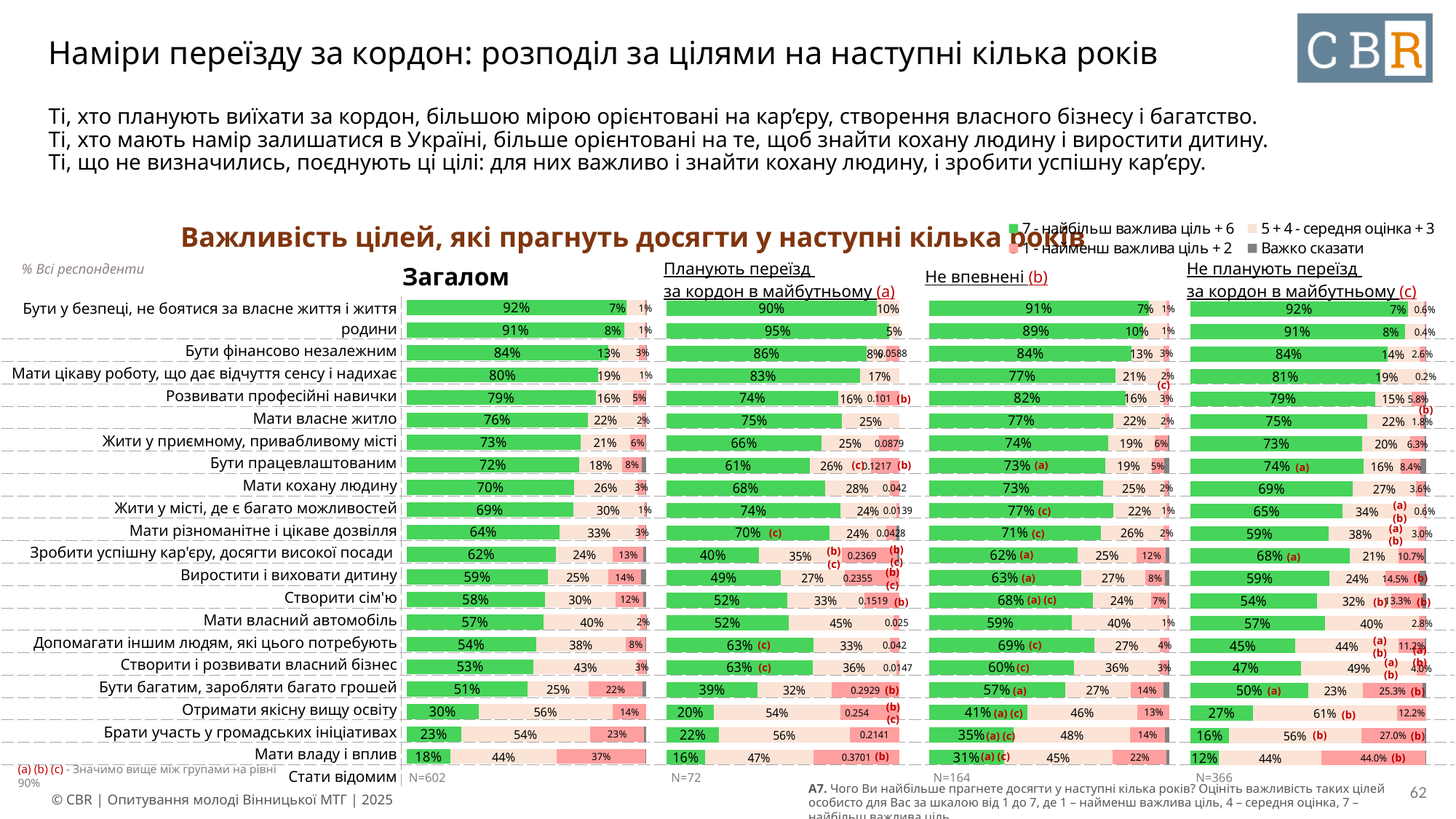
In the 'Загалом' chart, which goal has the lowest green (7 + 6) share? Мати владу і вплив What type of chart is used on this slide? Stacked bar chart What is the difference in percentage points between the green (7 + 6) share for 'Бути багатим, заробляти багато грошей' in the 'Не впевнені (b)' chart and in the 'Не планують переїзд за кордон в майбутньому (c)' chart? 7 percentage points In the 'Не планують переїзд за кордон в майбутньому (c)' chart, which goal has the lowest green (7 + 6) share? Мати владу і вплив Which is larger: the green (7 + 6) share for 'Створити сім'ю' in the 'Загалом' chart or in the 'Планують переїзд за кордон в майбутньому (a)' chart? Загалом In the 'Планують переїзд за кордон в майбутньому (a)' chart, what is the green (7 + 6) share for 'Зробити успішну кар'єру, досягти високої посади'? 40% In the 'Загалом' chart, what is the '5 + 4 - середня оцінка + 3' share for 'Отримати якісну вищу освіту'? 56% How many series does the legend list? 4 In the 'Загалом' chart, what percentage of respondents rated 'Мати владу і вплив' as 7 - найбільш важлива ціль + 6? 18% In the 'Не впевнені (b)' chart, what is the green (7 + 6) share for 'Створити сім'ю'? 68% What is the sample size (N) shown for the 'Планують переїзд за кордон в майбутньому (a)' chart? N=72 In the 'Не планують переїзд за кордон в майбутньому (c)' chart, what is the '1 - найменш важлива ціль + 2' share for 'Мати владу і вплив'? 44.0%